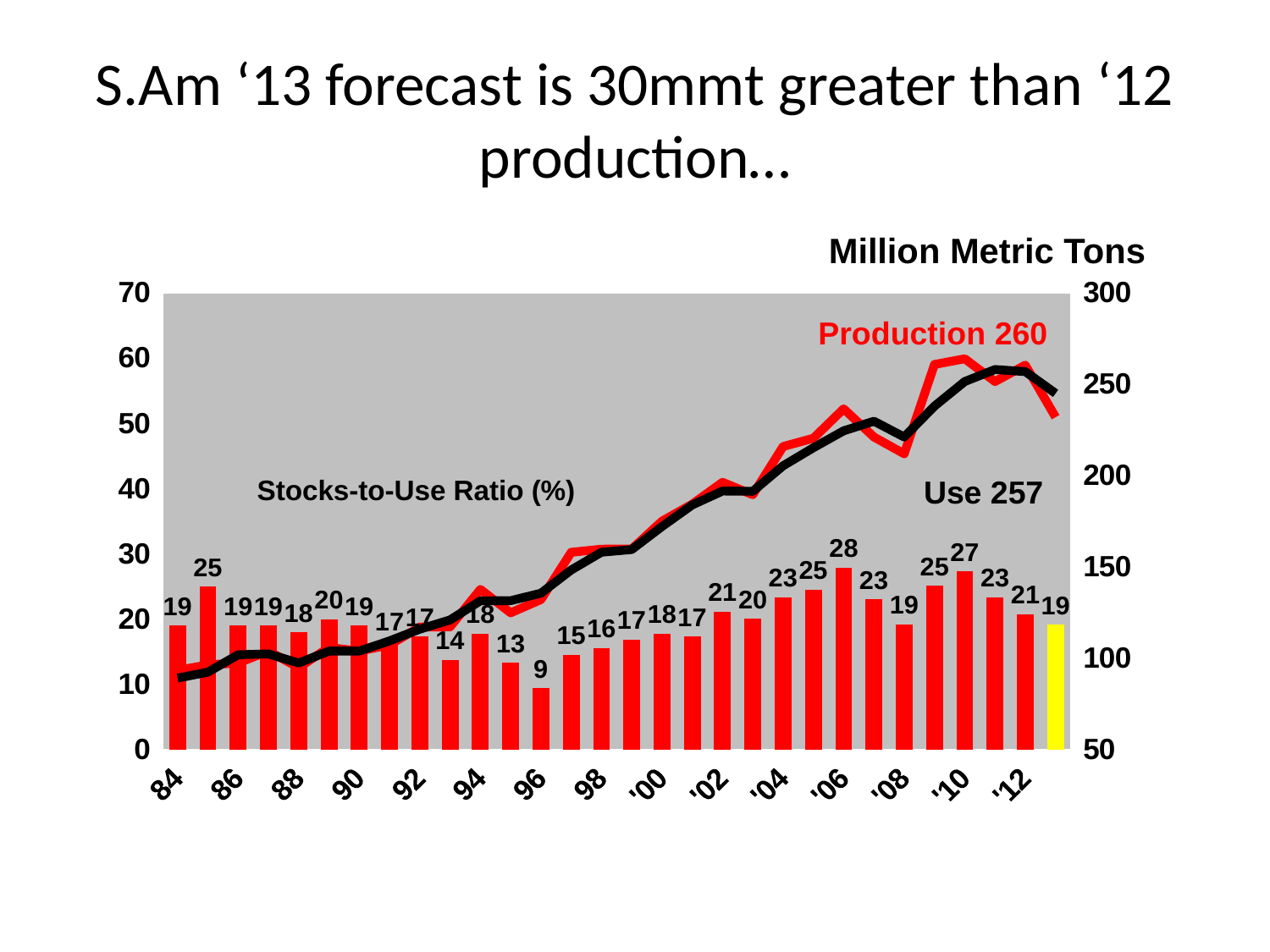
What is the latest Use value labelled on the chart? 257 Which has the larger stocks-to-use ratio, '84 or '85? '85 What is the difference between the labelled Production (260) and Use (257) values? 3 What is the stocks-to-use ratio shown for '84? 19 What is the title of the right-hand axis? Million Metric Tons What is the stocks-to-use ratio shown for '96? 9 What is the stocks-to-use ratio shown for '06? 28 What is the difference between the highest stocks-to-use ratio (28) and the lowest (9)? 19 Which year has the highest stocks-to-use ratio bar? '06 What is the latest Production value labelled on the chart? 260 Does the Production line generally rise or fall from '84 to '12? rise Which year has the lowest stocks-to-use ratio bar? '96